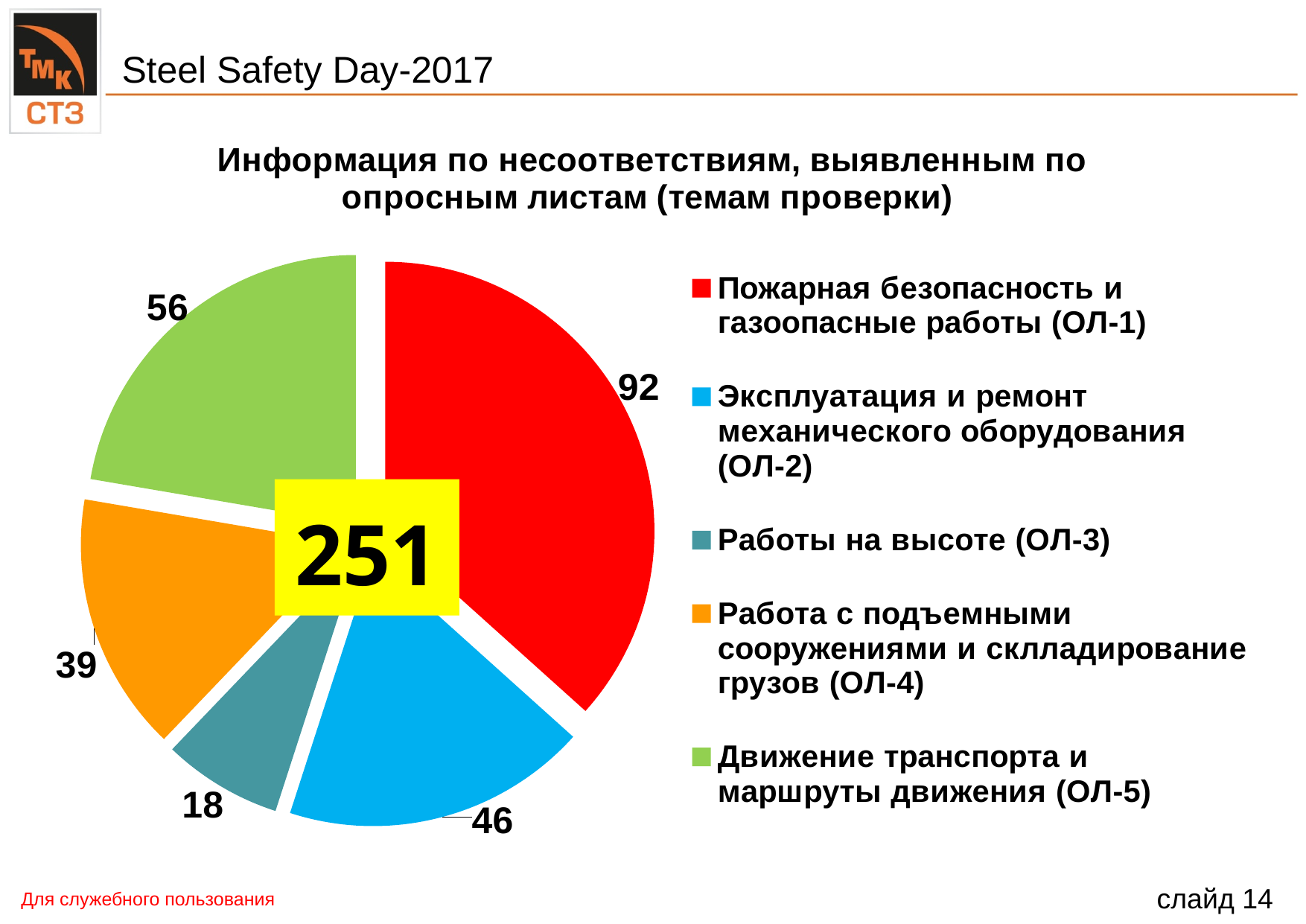
What type of chart is shown on the slide? Pie chart What is the value for Эксплуатация и ремонт механического оборудования (ОЛ-2)? 46 Which category has the largest slice of the pie? Пожарная безопасность и газоопасные работы (ОЛ-1) What total number is shown in the centre of the pie chart? 251 What is the value for Работы на высоте (ОЛ-3)? 18 What is the value for Работа с подъемными сооружениями и складирование грузов (ОЛ-4)? 39 What is the value for Пожарная безопасность и газоопасные работы (ОЛ-1)? 92 What is the difference between the values for ОЛ-1 and ОЛ-2? 46 Which category has the smallest slice of the pie? Работы на высоте (ОЛ-3) Which is larger, the value for ОЛ-5 or the value for ОЛ-4? ОЛ-5 How many slices does the pie chart have? 5 What is the value for Движение транспорта и маршруты движения (ОЛ-5)? 56